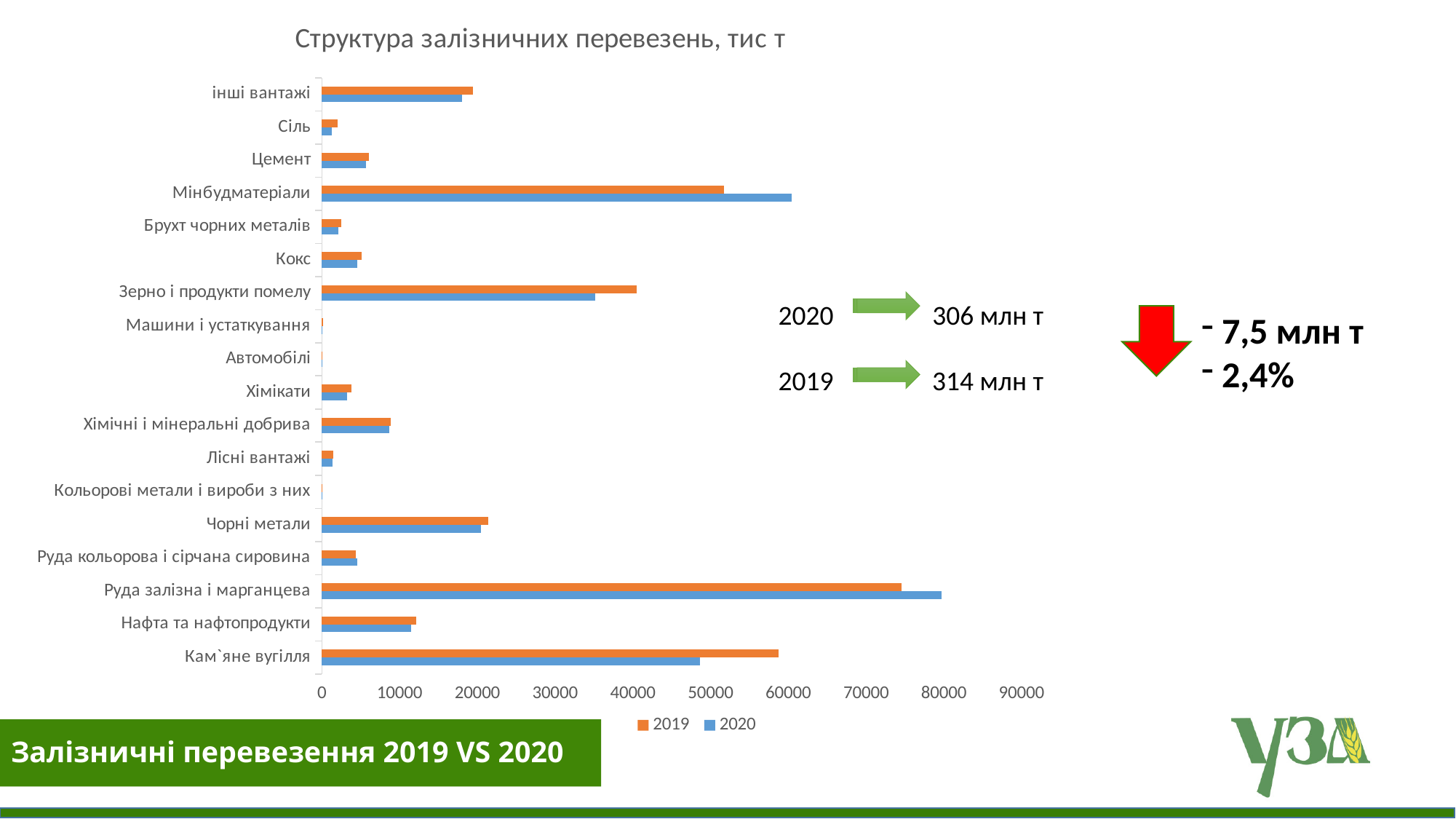
Which category has the highest value for 2019? Руда залізна і марганцева For Мінбудматеріали, which year has the larger value, 2019 or 2020? 2020 What kind of chart is shown on the slide? bar chart What is the title of the chart? Структура залізничних перевезень, тис т Is the 2019 value for Мінбудматеріали greater or less than 50000? greater Which category has the highest value for 2020? Руда залізна і марганцева How many series does the chart legend list? 2 How many cargo categories are plotted on the chart? 18 For Кам`яне вугілля, which year has the larger value, 2019 or 2020? 2019 Is the 2020 value for Руда залізна і марганцева greater or less than 70000? greater Is the 2020 value for Зерно і продукти помелу greater or less than 30000? greater